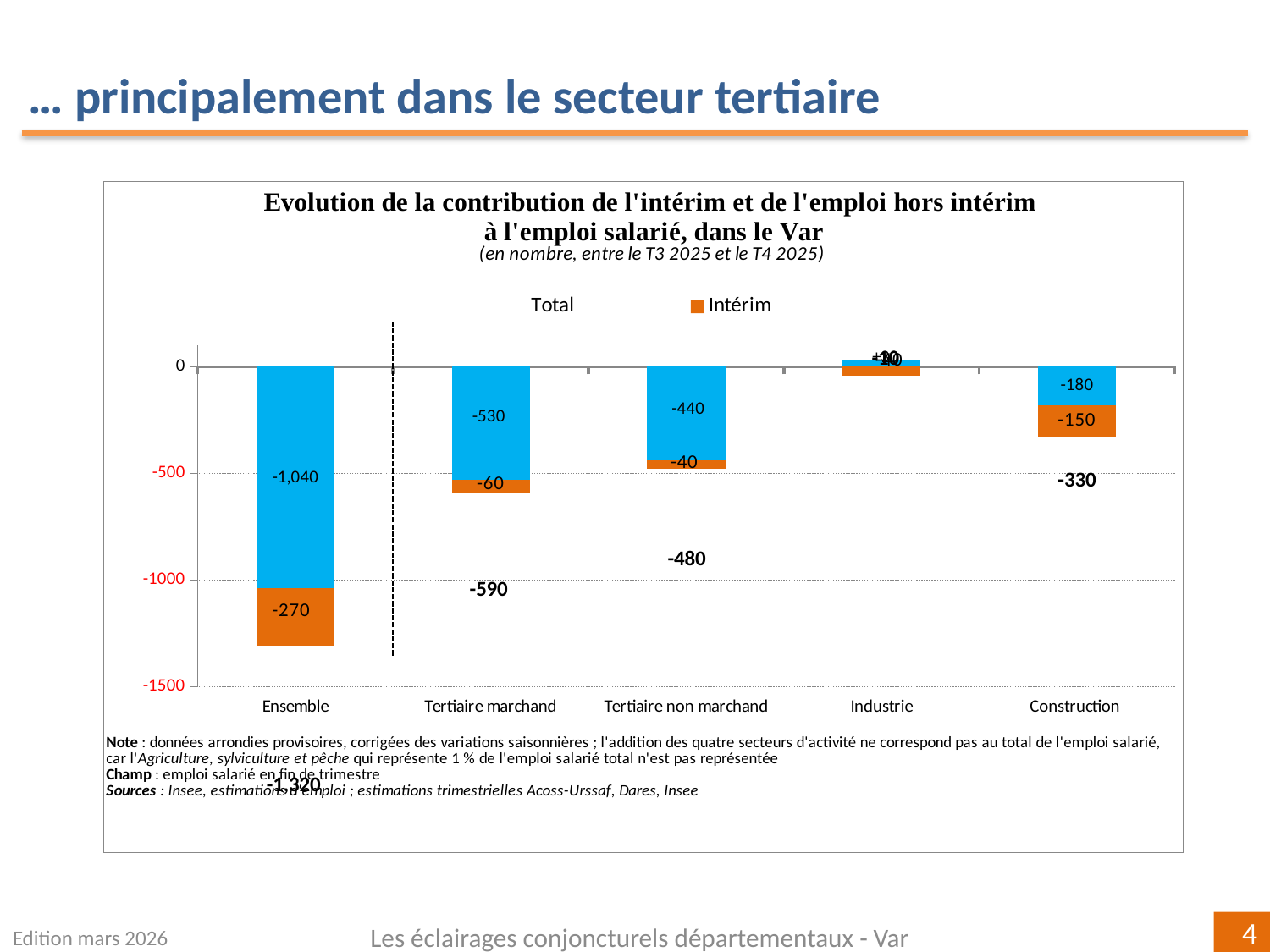
What is the value of the blue segment for Tertiaire non marchand? -440 Which category has the lowest total? Ensemble What is the value of the blue segment for Ensemble? -1,040 Which category has the lower Intérim value, Ensemble or Construction? Ensemble What is the total printed for the Construction bar? -330 What is the Intérim value for Construction? -150 What is the Intérim value for Tertiaire marchand? -60 How many categories are shown on the x axis? 5 What is the total printed for the Tertiaire marchand bar? -590 How many series does the legend list? 2 What is the difference between the Intérim values for Tertiaire marchand and Tertiaire non marchand? 20 What kind of chart is this? Stacked bar chart